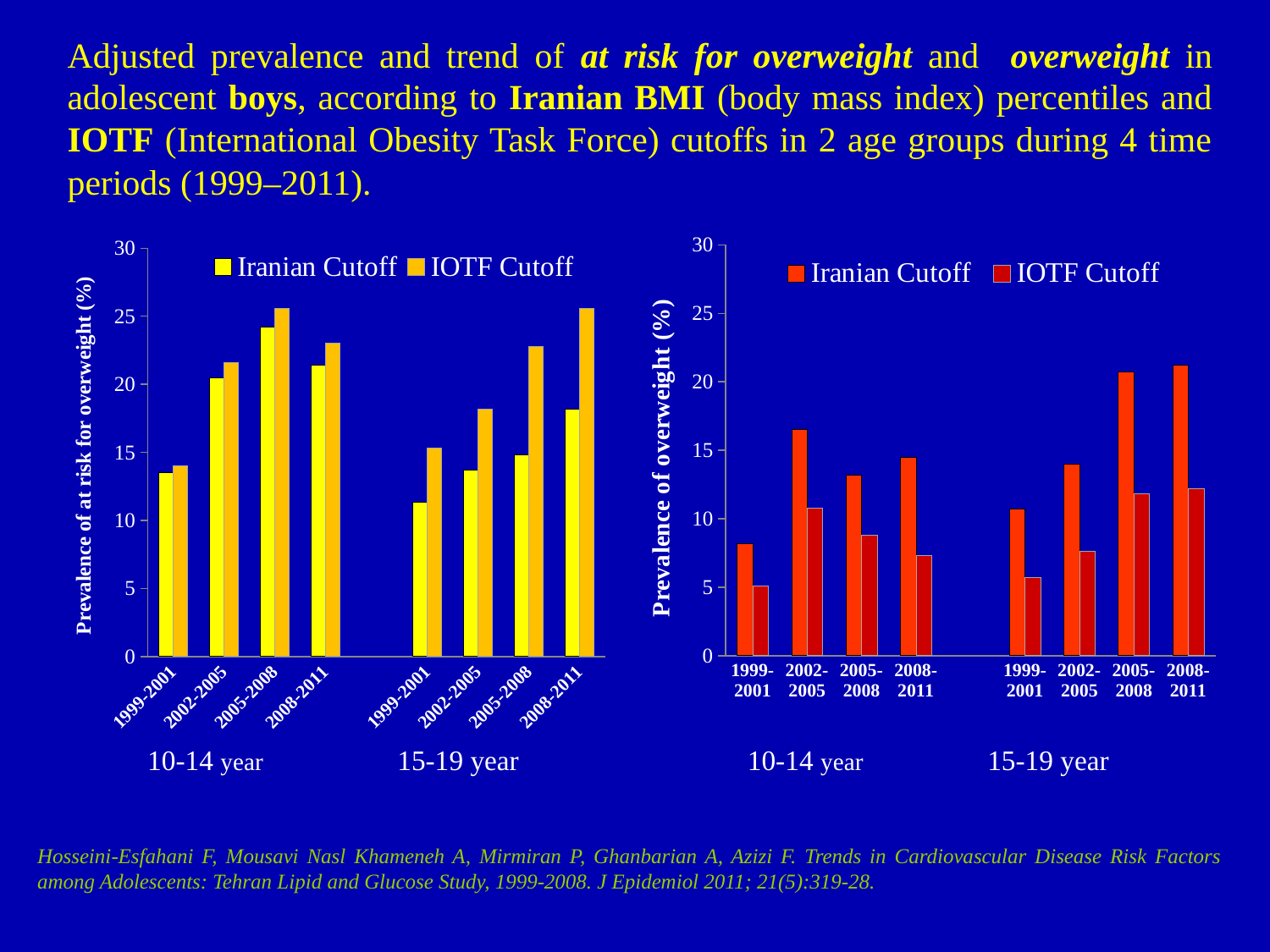
In the left chart (Prevalence of at risk for overweight), is the IOTF Cutoff value for 1999-2001 in the 15-19 year group greater or less than 20? less In the right chart (Prevalence of overweight), which time period has the lowest IOTF Cutoff value in the 10-14 year group? 1999-2001 How many time periods are shown for each age group in the right chart (Prevalence of overweight)? 4 In the left chart (Prevalence of at risk for overweight), which time period has the highest Iranian Cutoff value in the 10-14 year group? 2005-2008 In the left chart (Prevalence of at risk for overweight), which is larger for 2005-2008 in the 15-19 year group, Iranian Cutoff or IOTF Cutoff? IOTF Cutoff In the right chart (Prevalence of overweight), do the Iranian Cutoff values in the 15-19 year group rise or fall from 1999-2001 to 2008-2011? rise In the right chart (Prevalence of overweight), is the Iranian Cutoff value for 1999-2001 in the 10-14 year group greater or less than 10? less How many series does the legend of the left chart (Prevalence of at risk for overweight) list? 2 What kind of chart is the left chart (Prevalence of at risk for overweight)? bar chart In the right chart (Prevalence of overweight), which is larger for 2002-2005 in the 10-14 year group, Iranian Cutoff or IOTF Cutoff? Iranian Cutoff In the left chart (Prevalence of at risk for overweight), is the Iranian Cutoff value for 2005-2008 in the 10-14 year group greater or less than 20? greater What is the y-axis title of the right chart? Prevalence of overweight (%)